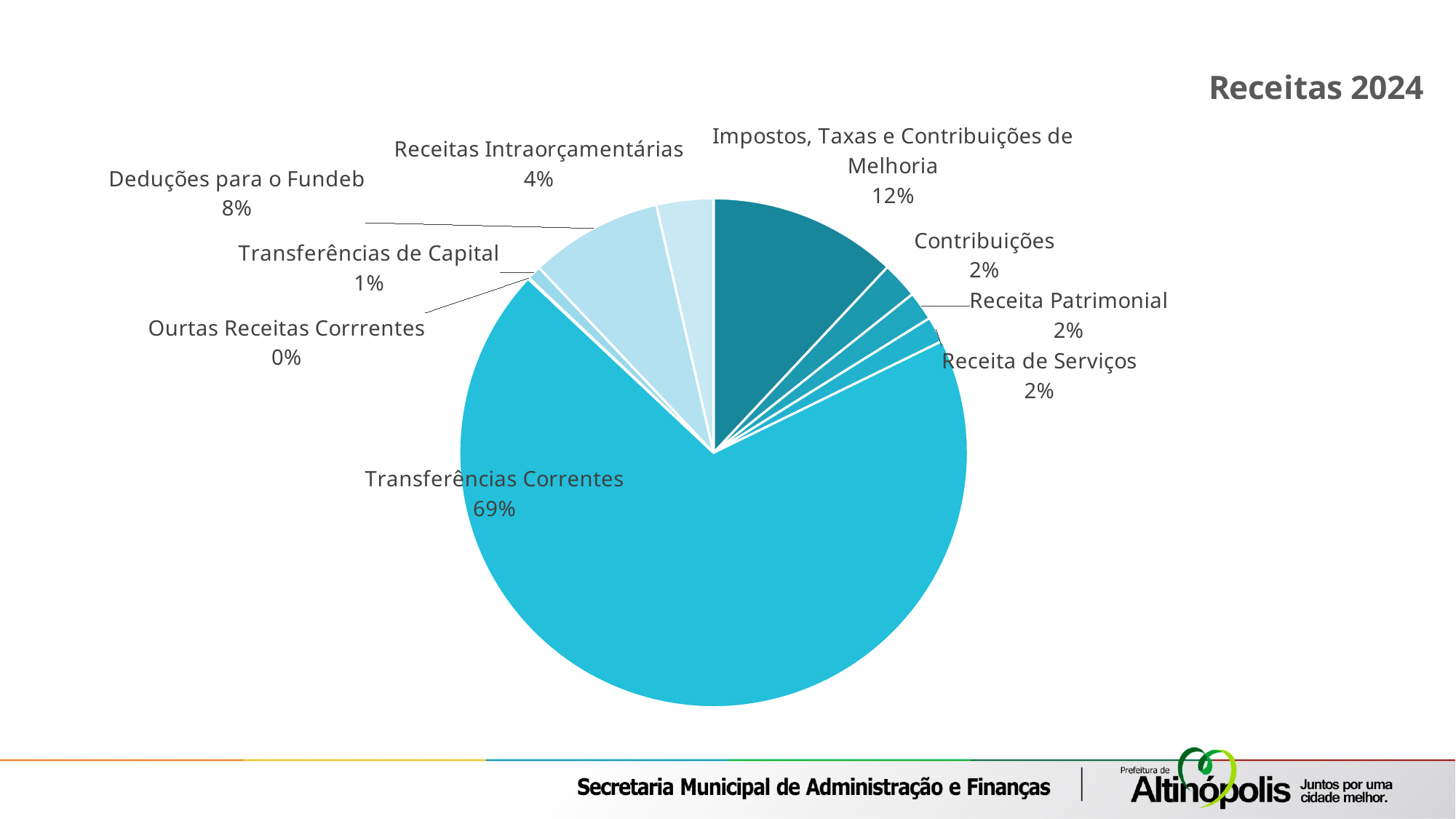
What percentage is shown for Impostos, Taxas e Contribuições de Melhoria? 12% Which category has the largest share of the pie? Transferências Correntes What percentage is shown for Deduções para o Fundeb? 8% What is the title of the chart? Receitas 2024 What share of the pie does Transferências Correntes represent? 69% What is the difference in percentage points between Transferências Correntes and Impostos, Taxas e Contribuições de Melhoria? 57 What kind of chart is shown on the slide? Pie chart Which category has the smallest share of the pie? Ourtas Receitas Corrrentes How many categories are shown in the pie chart? 9 What percentage is shown for Transferências de Capital? 1% What percentage is shown for Receitas Intraorçamentárias? 4% Which is larger, Deduções para o Fundeb or Receitas Intraorçamentárias? Deduções para o Fundeb